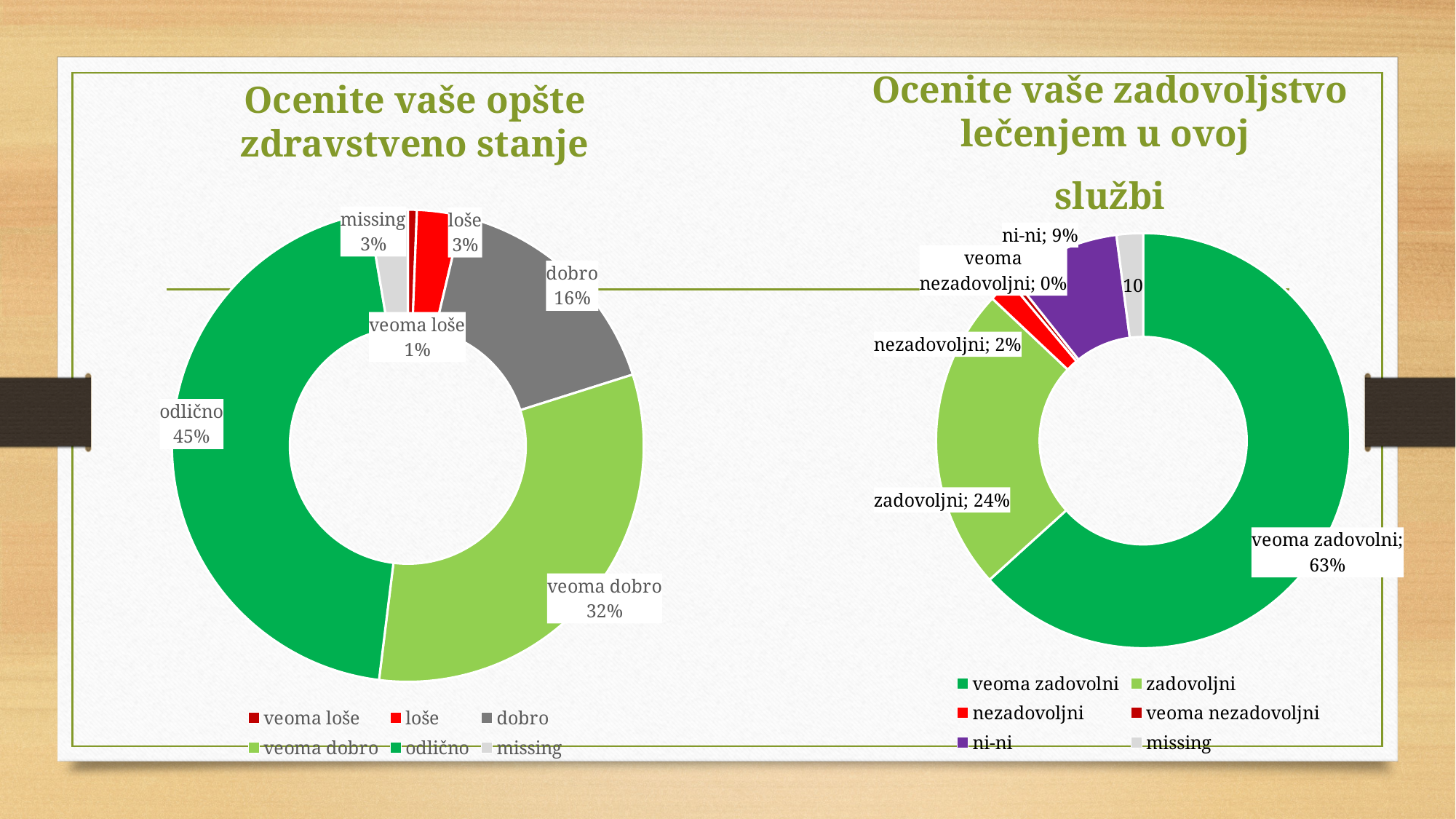
In the chart titled 'Ocenite vaše zadovoljstvo lečenjem u ovoj službi', what percentage is shown for 'ni-ni'? 9% In the chart titled 'Ocenite vaše opšte zdravstveno stanje', what percentage is shown for 'odlično'? 45% In the chart titled 'Ocenite vaše opšte zdravstveno stanje', what is the difference in percentage points between 'odlično' and 'veoma dobro'? 13 In the chart titled 'Ocenite vaše opšte zdravstveno stanje', which category has the largest share? odlično In the chart titled 'Ocenite vaše opšte zdravstveno stanje', what percentage is shown for 'dobro'? 16% In the chart titled 'Ocenite vaše opšte zdravstveno stanje', how many categories does the legend list? 6 In the chart titled 'Ocenite vaše zadovoljstvo lečenjem u ovoj službi', what is the difference in percentage points between 'veoma zadovolni' and 'zadovoljni'? 39 In the chart titled 'Ocenite vaše zadovoljstvo lečenjem u ovoj službi', what percentage is shown for 'veoma nezadovoljni'? 0% What kind of chart is used on the left side of the slide? doughnut chart In the chart titled 'Ocenite vaše zadovoljstvo lečenjem u ovoj službi', what percentage is shown for 'veoma zadovolni'? 63% In the chart titled 'Ocenite vaše zadovoljstvo lečenjem u ovoj službi', which is larger, 'zadovoljni' or 'ni-ni'? zadovoljni In the chart titled 'Ocenite vaše opšte zdravstveno stanje', which category has the smallest share? veoma loše